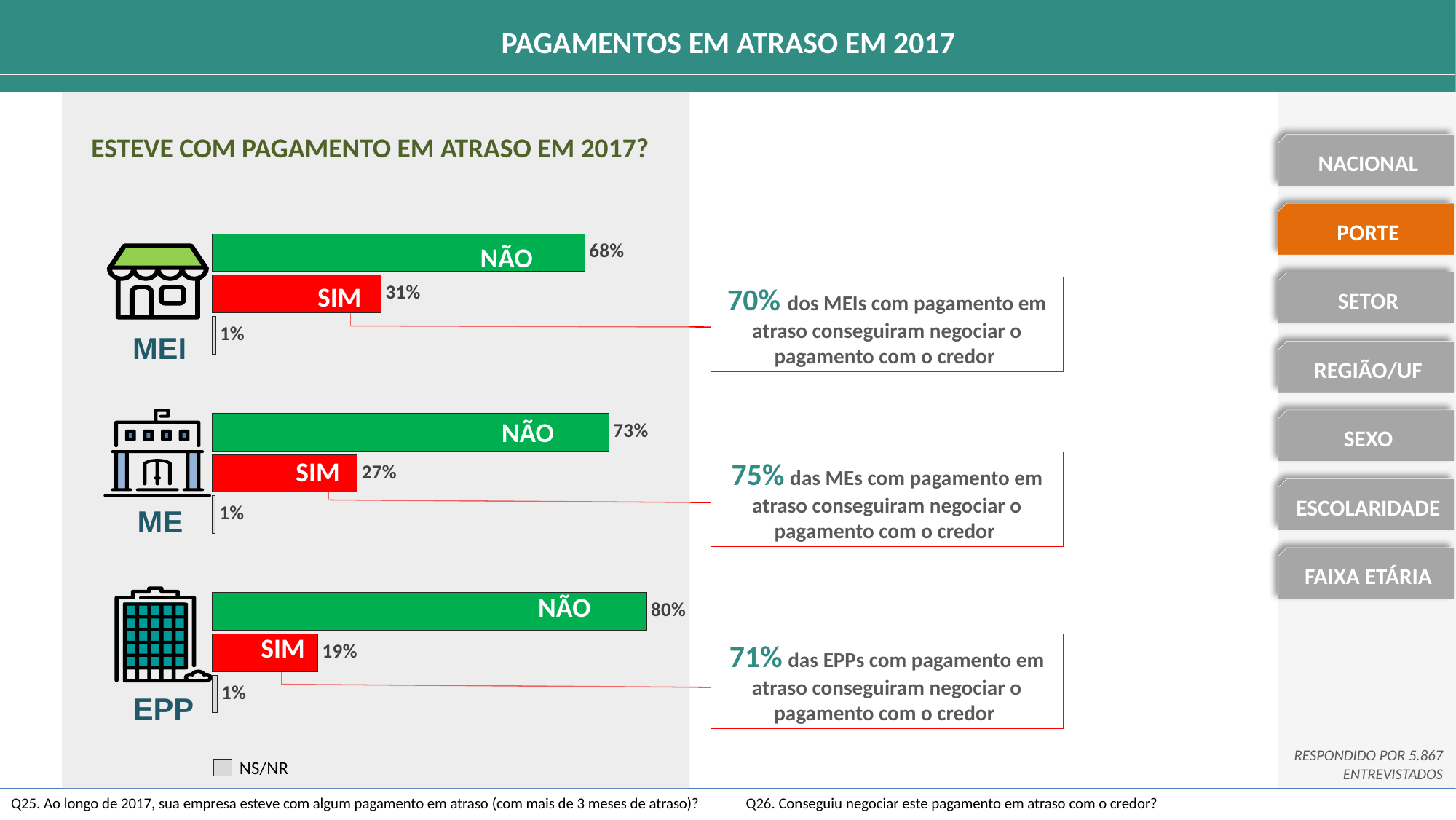
What percentage of MEI respondents answered NÃO to having late payments in 2017? 68% What is the difference between the SIM percentage for MEI and the SIM percentage for EPP? 12% Which company size (MEI, ME or EPP) has the lowest share answering NÃO? MEI What percentage of EPP respondents answered NÃO? 80% What is the NS/NR value shown for EPP? 1% Which is larger: the SIM percentage for ME or the SIM percentage for EPP? ME What colour are the SIM bars in the chart? Red What is the difference between the NÃO percentage for EPP and the NÃO percentage for MEI? 12% How many company size categories are shown in the chart? 3 What type of chart is used to show the responses? Bar chart What percentage of ME respondents answered SIM to having late payments in 2017? 27% Which company size (MEI, ME or EPP) has the highest share answering SIM? MEI